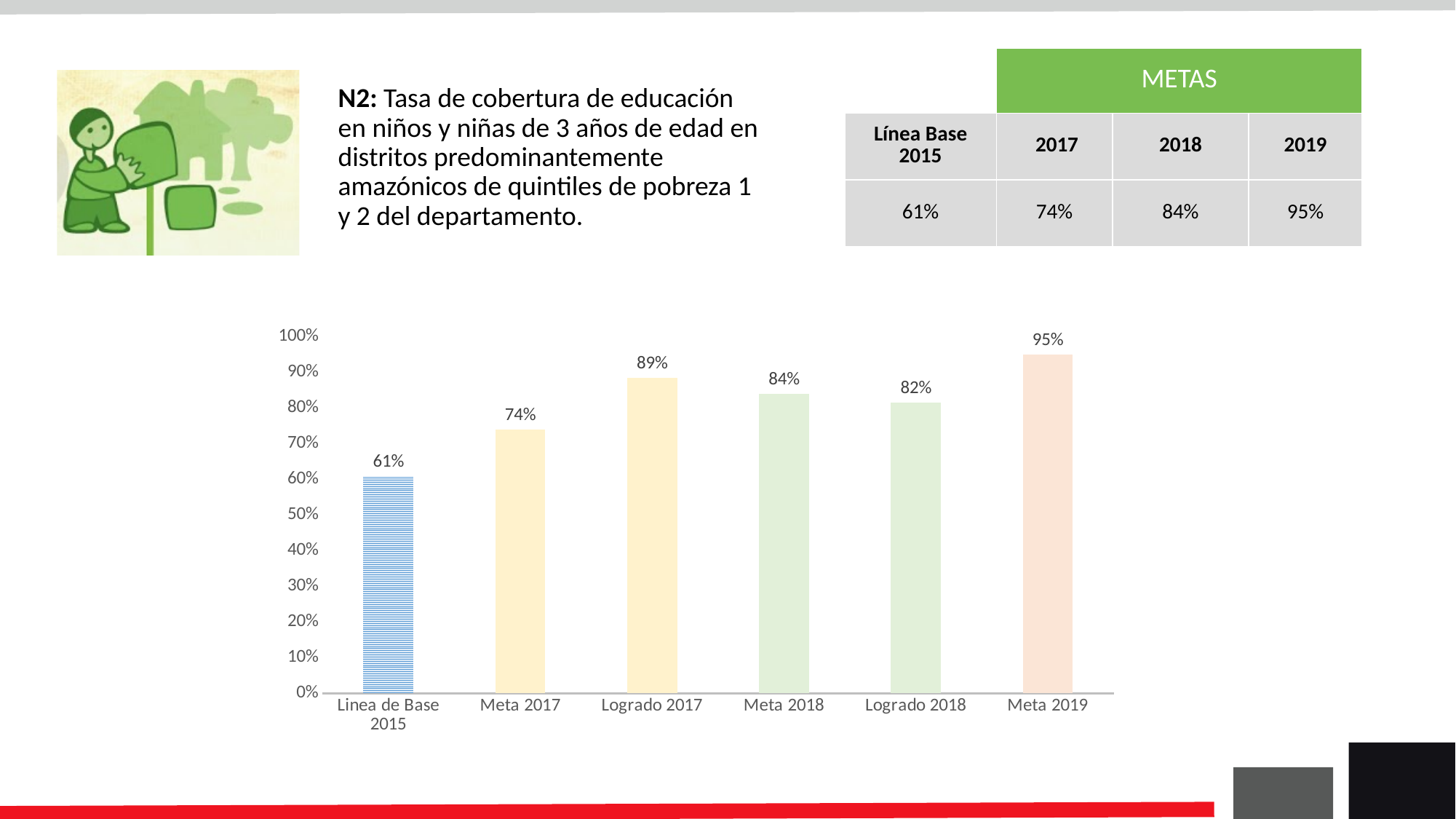
Is the value for Meta 2017 greater or less than 70%? greater Which category has the lowest value? Linea de Base 2015 What is the value for Logrado 2018? 82% What is the value for Logrado 2017? 89% Which category has the highest value? Meta 2019 Which is larger, Logrado 2017 or Meta 2018? Logrado 2017 How many categories are shown on the x axis? 6 What is the value for Linea de Base 2015? 61% What is the value for Meta 2019? 95% What is the difference between Meta 2018 and Logrado 2018? 2% What is the difference between Logrado 2017 and Meta 2017? 15% What kind of chart is shown on the slide? bar chart